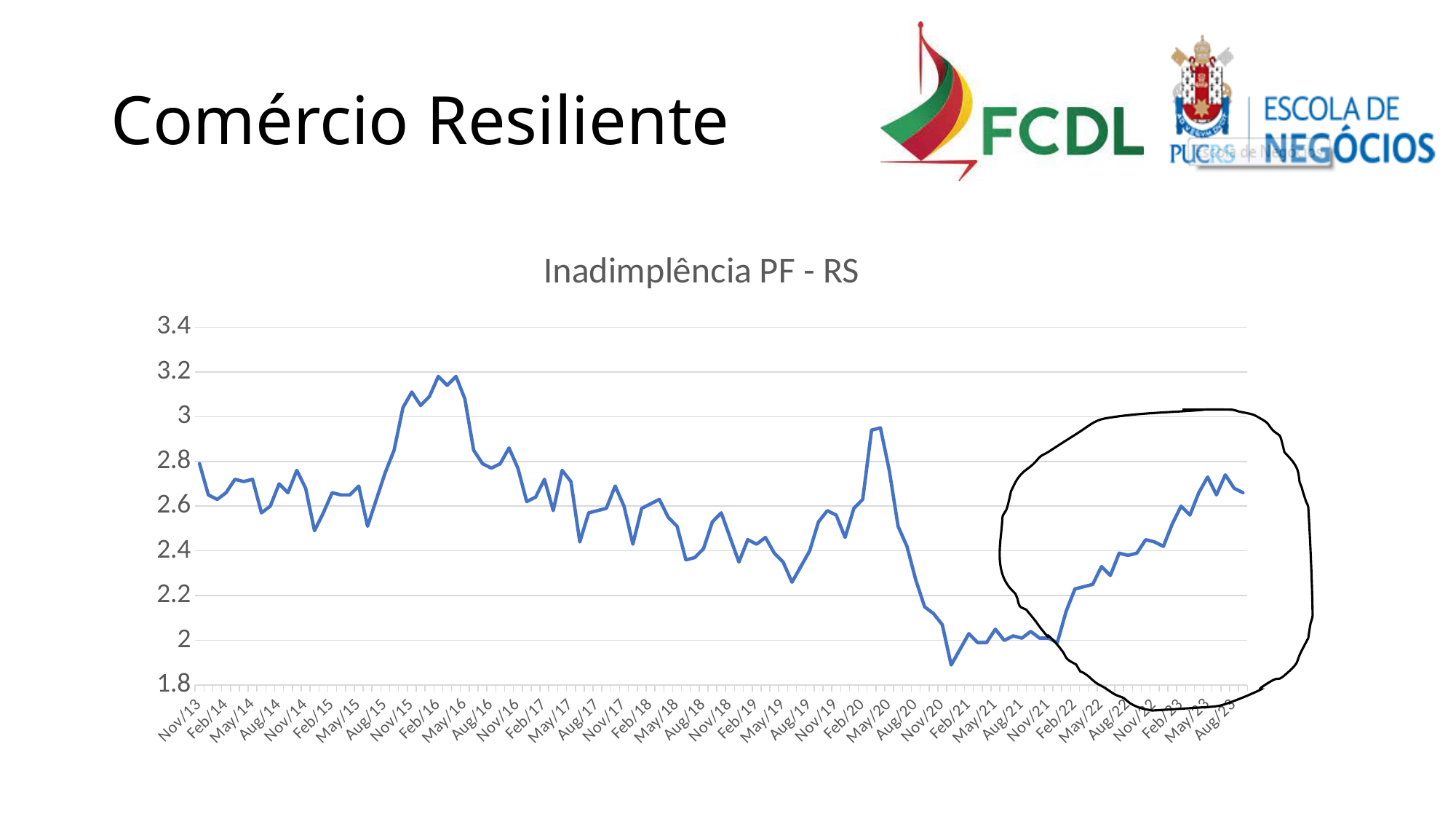
Is the peak value of the series greater or less than 3? greater Is the value for Aug/23 greater or less than 2.4? greater Which is larger, the value for Nov/13 or the value for Feb/21? Nov/13 What is the highest value shown on the vertical axis of the chart? 3.4 What is the title of the chart? Inadimplência PF - RS Is the value for Feb/22 greater or less than 2.4? less What kind of chart is shown on the slide? line chart Do the values rise or fall between May/20 and Feb/21? fall Do the values rise or fall between Feb/22 and Aug/23? rise